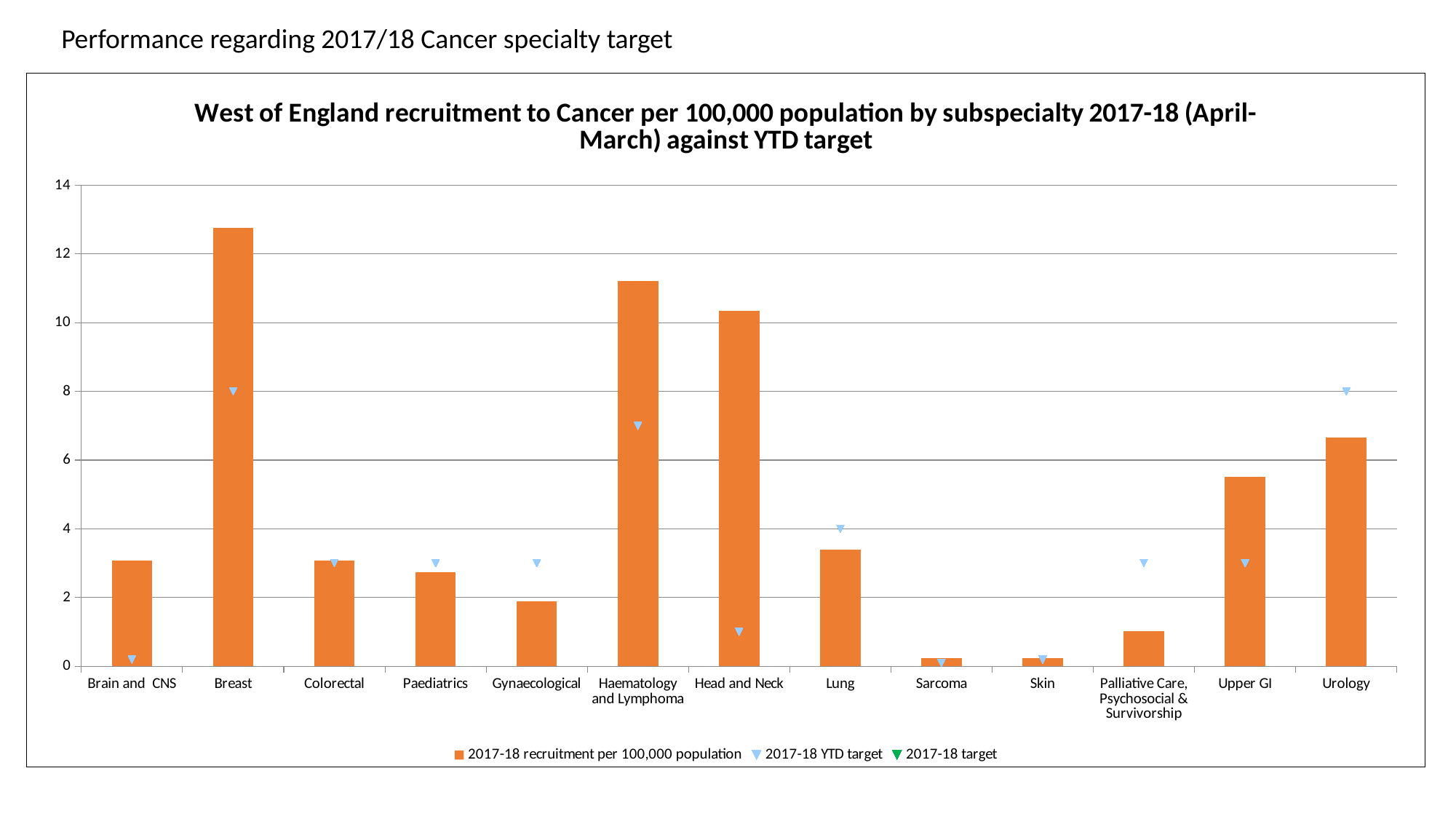
How many subspecialty categories are shown on the x axis? 13 What kind of chart is shown on the slide? bar chart What colour are the bars for 2017-18 recruitment per 100,000 population? orange Is the 2017-18 recruitment per 100,000 population for Gynaecological greater or less than 2? less Is the 2017-18 recruitment per 100,000 population for Lung greater or less than 4? less Is the 2017-18 recruitment per 100,000 population for Breast greater or less than 12? greater Which subspecialty has the highest 2017-18 recruitment per 100,000 population? Breast Which has the larger 2017-18 recruitment per 100,000 population, Upper GI or Urology? Urology How many series does the legend list? 3 For Urology, which is larger, the 2017-18 recruitment per 100,000 population or the 2017-18 YTD target? 2017-18 YTD target